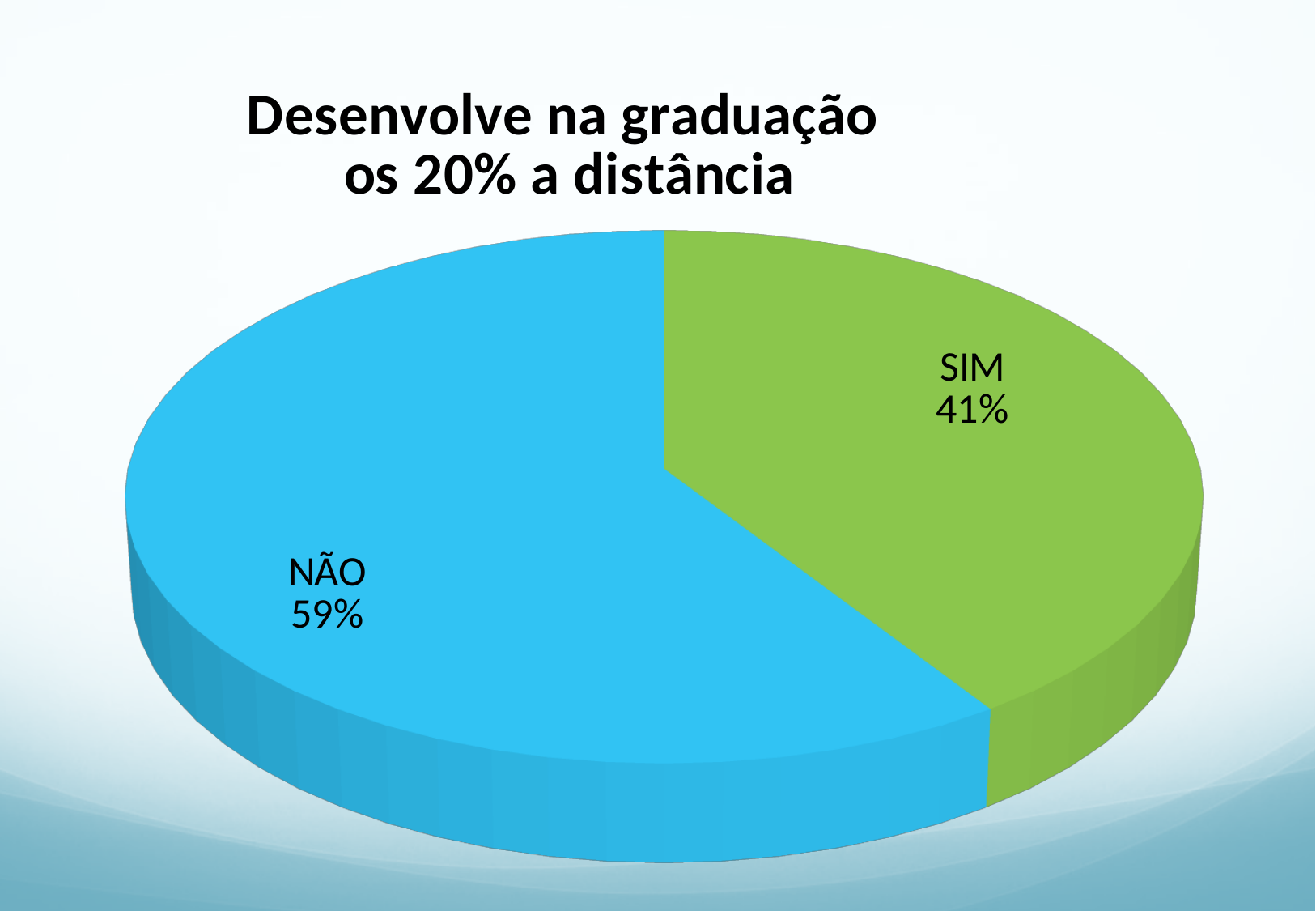
Which is larger, the SIM slice or the NÃO slice? NÃO Is the value for SIM greater or less than 50%? less What share of the pie does the NÃO slice represent? 59% Which slice is the largest? NÃO What colour is the SIM slice? Green What is the difference in percentage points between the NÃO and SIM slices? 18 Which slice is the smallest? SIM What kind of chart is shown on the slide? Pie chart What is the title of the chart? Desenvolve na graduação os 20% a distância What share of the pie does the SIM slice represent? 41% How many slices does the pie chart have? 2